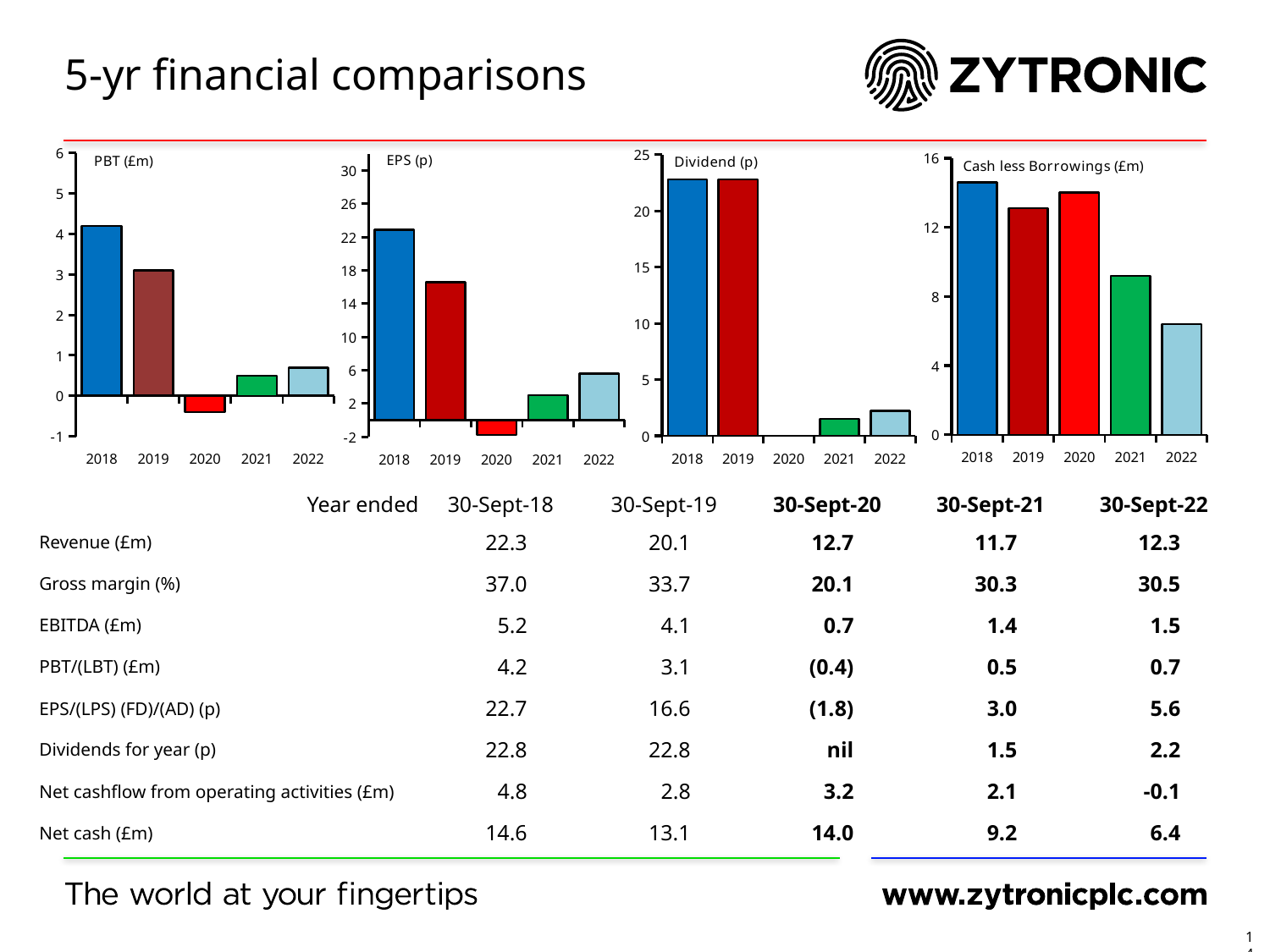
In the Dividend (p) chart, which year has the lowest value? 2020 In the EPS (p) chart, is the value for 2020 greater or less than 0? less In the EPS (p) chart, which is larger, the value for 2021 or the value for 2022? 2022 In the PBT (£m) chart, which year has the highest value? 2018 In the Cash less Borrowings (£m) chart, do the values rise or fall from 2020 to 2022? fall In the PBT (£m) chart, how many years are plotted? 5 What is the title of the rightmost chart on the slide? Cash less Borrowings (£m) How many charts are shown on the slide? 4 What type of chart is the PBT (£m) chart? bar chart In the Cash less Borrowings (£m) chart, is the value for 2022 greater or less than 8? less In the PBT (£m) chart, which year has the lowest value? 2020 In the EPS (p) chart, is the value for 2018 greater or less than 20? greater